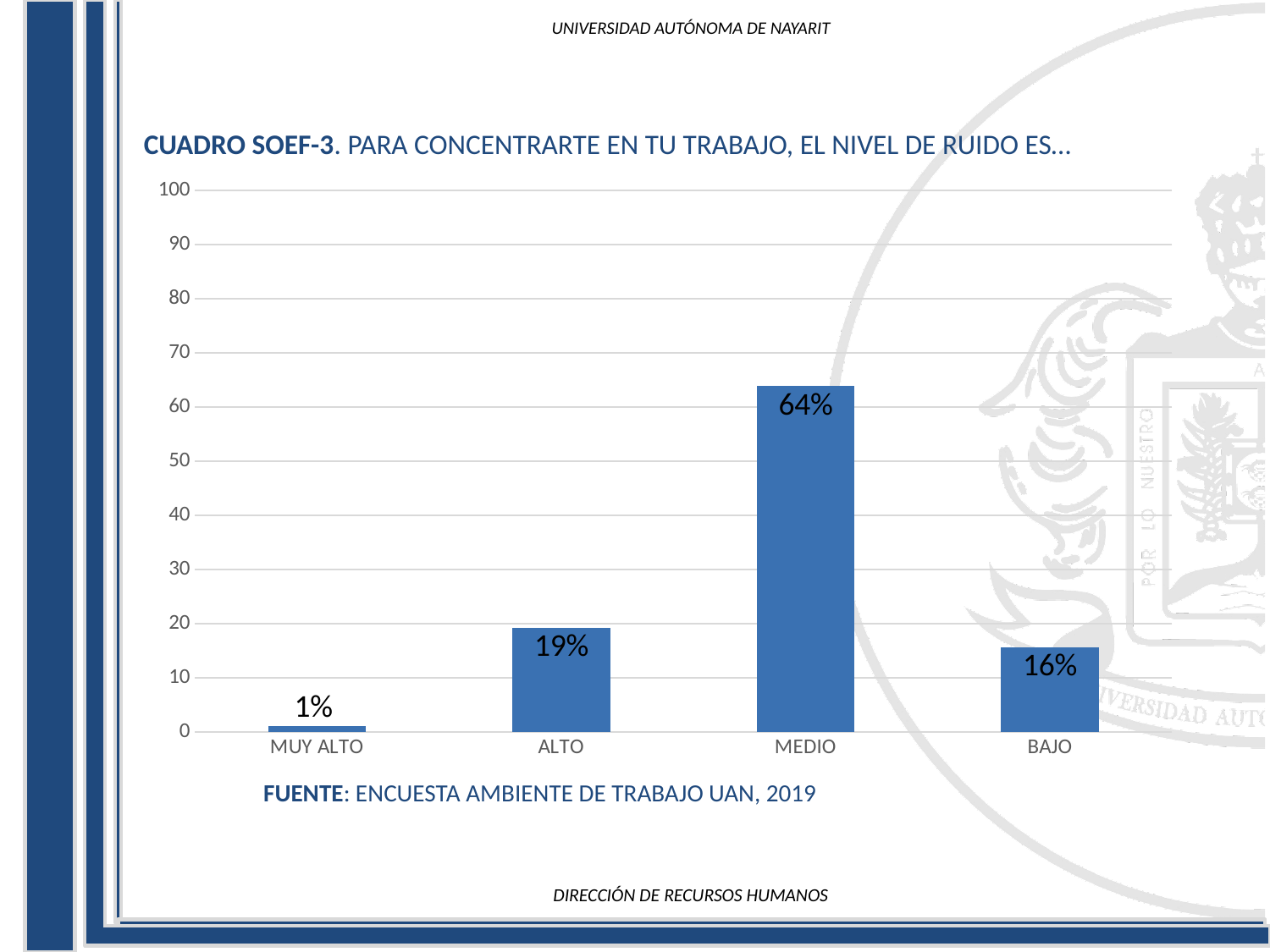
Which category has the lowest value? MUY ALTO What is the value for MUY ALTO? 1% Which category has the highest value? MEDIO What is the difference between the values for MEDIO and ALTO? 45% What source is cited below the chart? ENCUESTA AMBIENTE DE TRABAJO UAN, 2019 What is the value for BAJO? 16% What is the value for ALTO? 19% What kind of chart is shown on the slide? bar chart How many categories are shown on the x axis? 4 Is the value for MEDIO greater or less than 50? greater What is the value for MEDIO? 64% Which is larger, the value for ALTO or the value for BAJO? ALTO